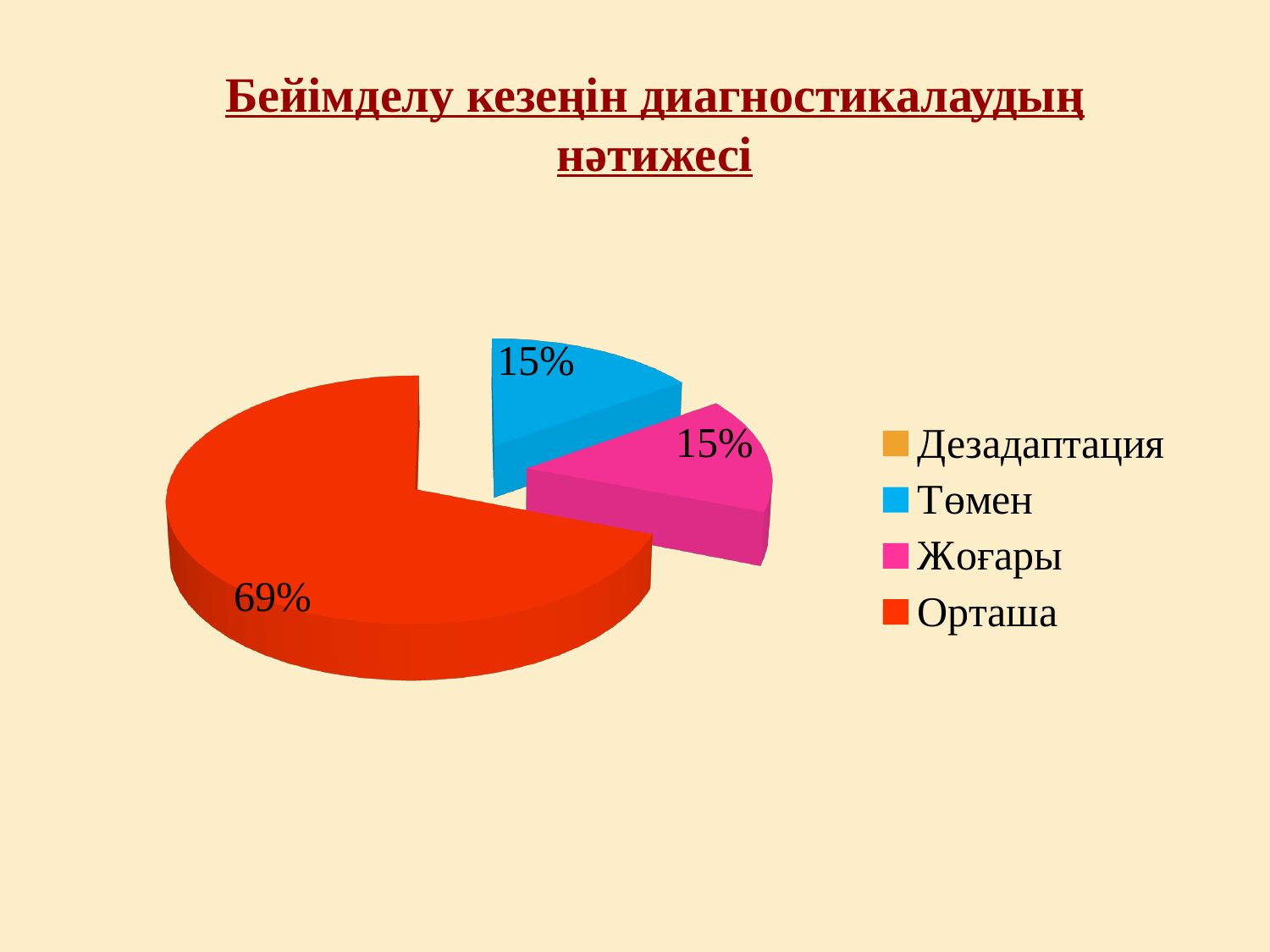
Which category has the largest slice of the pie? Орташа What colour is the slice for Орташа? Red What percentage is shown for Төмен? 15% Which legend category has no visible slice in the pie? Дезадаптация What share of the pie does Орташа have? 69% Which is larger, the slice for Орташа or the slice for Төмен? Орташа What percentage is shown for Жоғары? 15% How many categories does the legend list? 4 What kind of chart is shown on the slide? Pie chart Is the share for Орташа greater or less than 50%? greater By how many percentage points does Орташа exceed Жоғары? 54